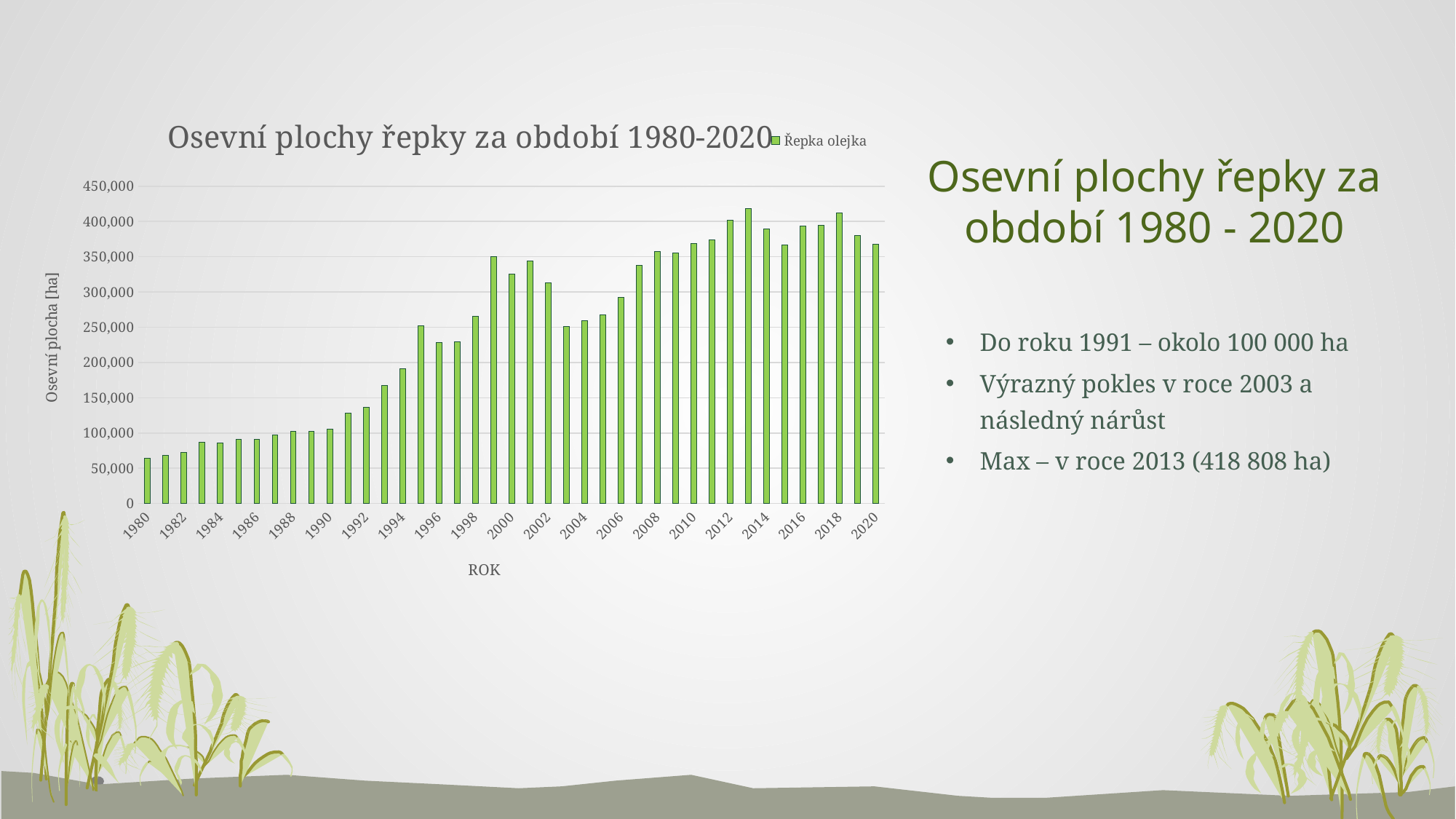
Overall, do the values rise or fall from 1980 to 2020? rise What is the title of the chart? Osevní plochy řepky za období 1980-2020 Which year has the larger value, 2002 or 2003? 2002 Is the value for 1980 greater or less than 100,000? less How many series does the chart legend list? 1 Which year has the highest value in the chart? 2013 Is the value for 2013 greater or less than 400,000? greater What is the name of the series shown in the chart legend? Řepka olejka How many years (bars) are plotted in the chart? 41 Is the value for 2003 greater or less than 300,000? less Which year has the lowest value in the chart? 1980 What kind of chart is shown on the slide? Bar chart